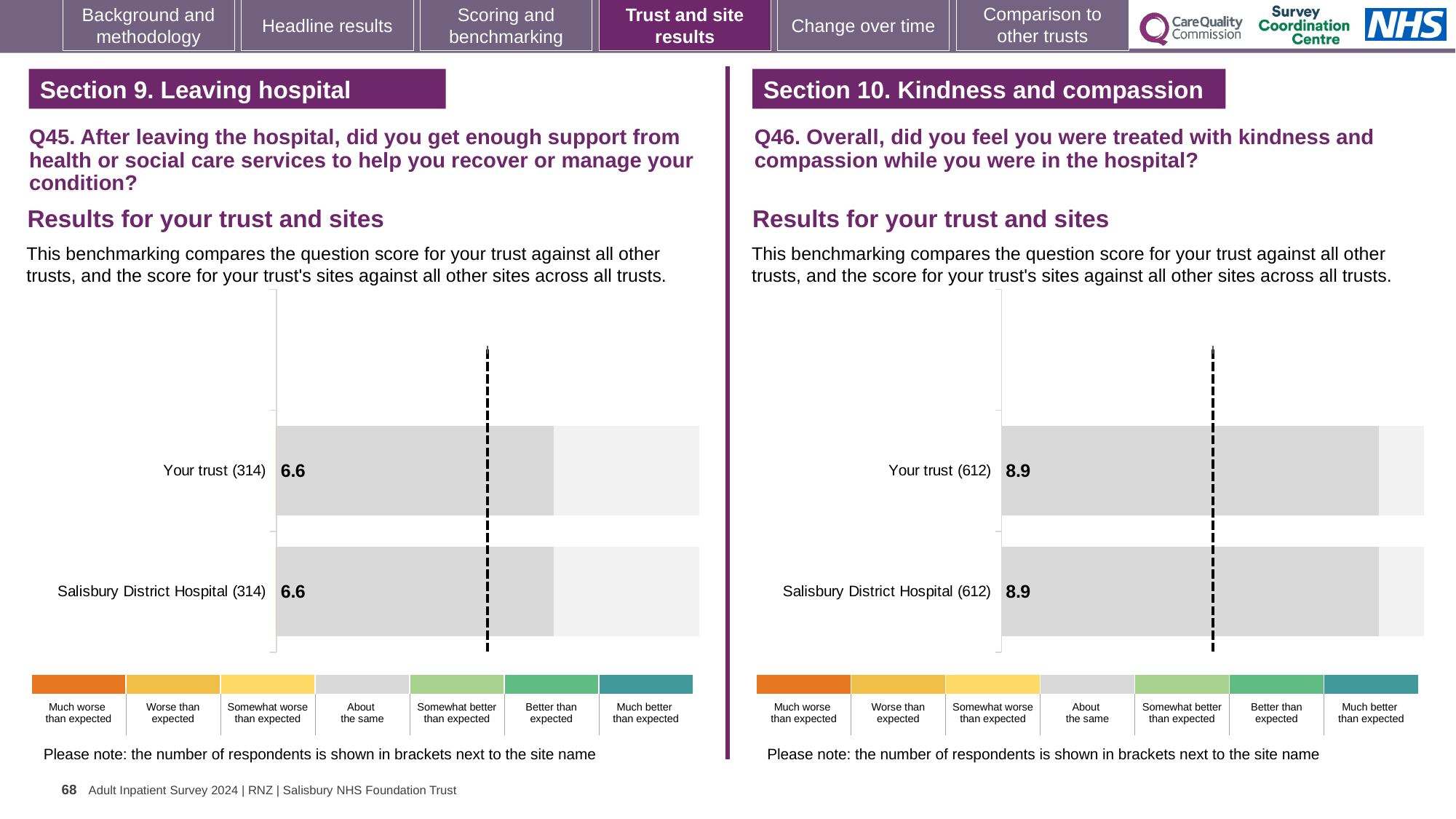
How many bars are plotted on the Q45 chart (left)? 2 On the Q45 chart (left), what is the difference between the score for Your trust and the score for Salisbury District Hospital? 0 What kind of chart is the Q46 chart (right)? Bar chart On the Q46 chart (right), what is the score for Your trust? 8.9 On the Q45 chart (left), how many respondents are shown in brackets for Your trust? 314 On the Q46 chart (right), what is the score for Salisbury District Hospital? 8.9 How many bars are plotted on the Q46 chart (right)? 2 On the Q45 chart (left), what is the score for Salisbury District Hospital? 6.6 On the Q46 chart (right), what is the difference between the score for Your trust and the score for Salisbury District Hospital? 0 On the Q46 chart (right), how many respondents are shown in brackets for Salisbury District Hospital? 612 How many categories does the colour key below the Q45 chart (left) list? 7 On the Q45 chart (left), what is the score for Your trust? 6.6